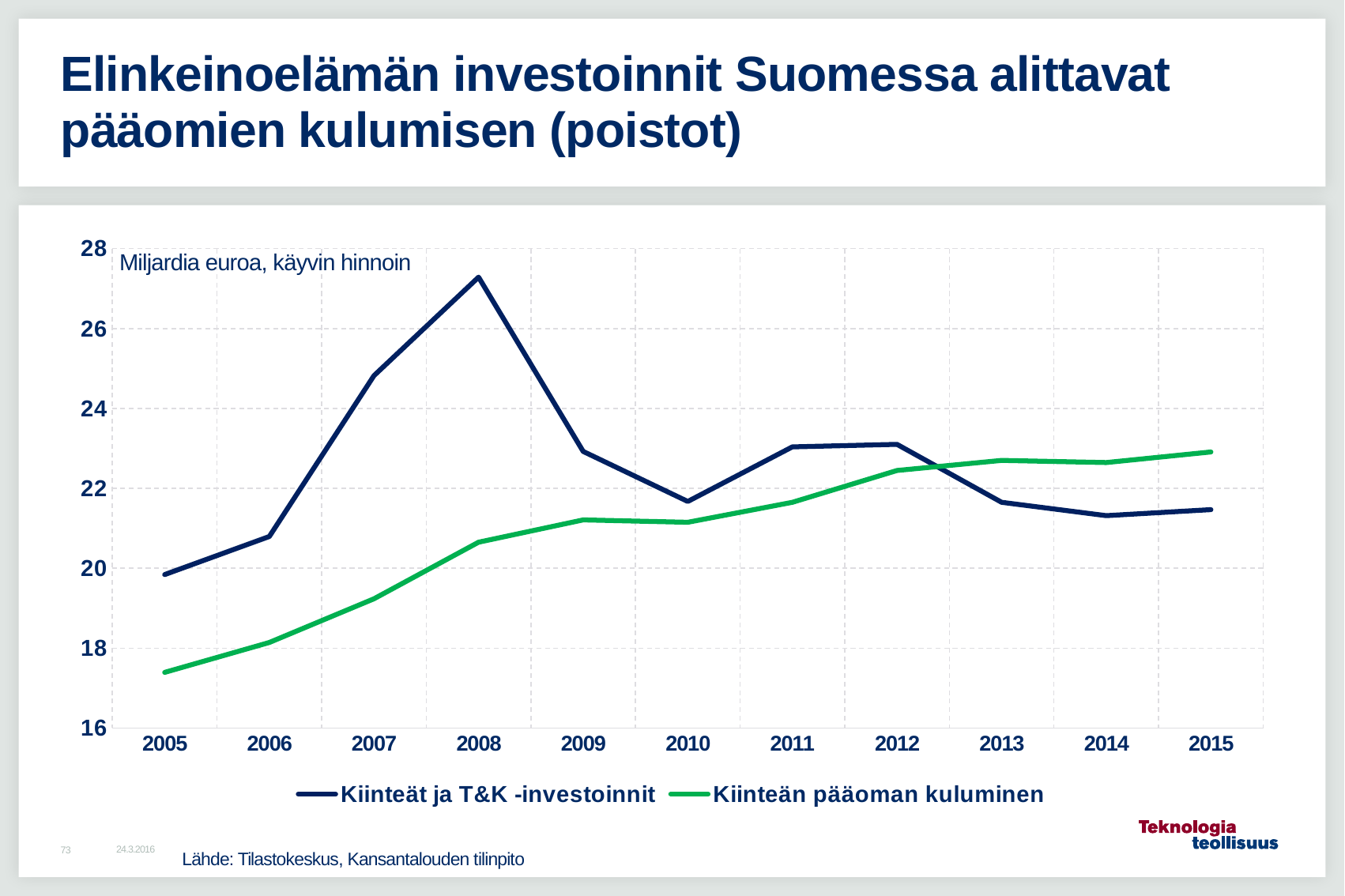
Is the value for Kiinteän pääoman kuluminen in 2005 greater or less than 18? less Is the value for Kiinteät ja T&K -investoinnit in 2015 greater or less than 22? less In 2015, which series has the higher value, Kiinteät ja T&K -investoinnit or Kiinteän pääoman kuluminen? Kiinteän pääoman kuluminen How many years are plotted along the x axis? 11 Does the Kiinteän pääoman kuluminen line generally rise or fall from 2005 to 2015? rise What unit is stated in the chart's label at the top left of the plot area? Miljardia euroa, käyvin hinnoin Is the value for Kiinteän pääoman kuluminen in 2015 greater or less than 22? greater How many series does the legend list? 2 In which year is the Kiinteän pääoman kuluminen line at its lowest? 2005 In which year does the Kiinteät ja T&K -investoinnit line reach its highest value? 2008 What kind of chart is shown on the slide? line chart